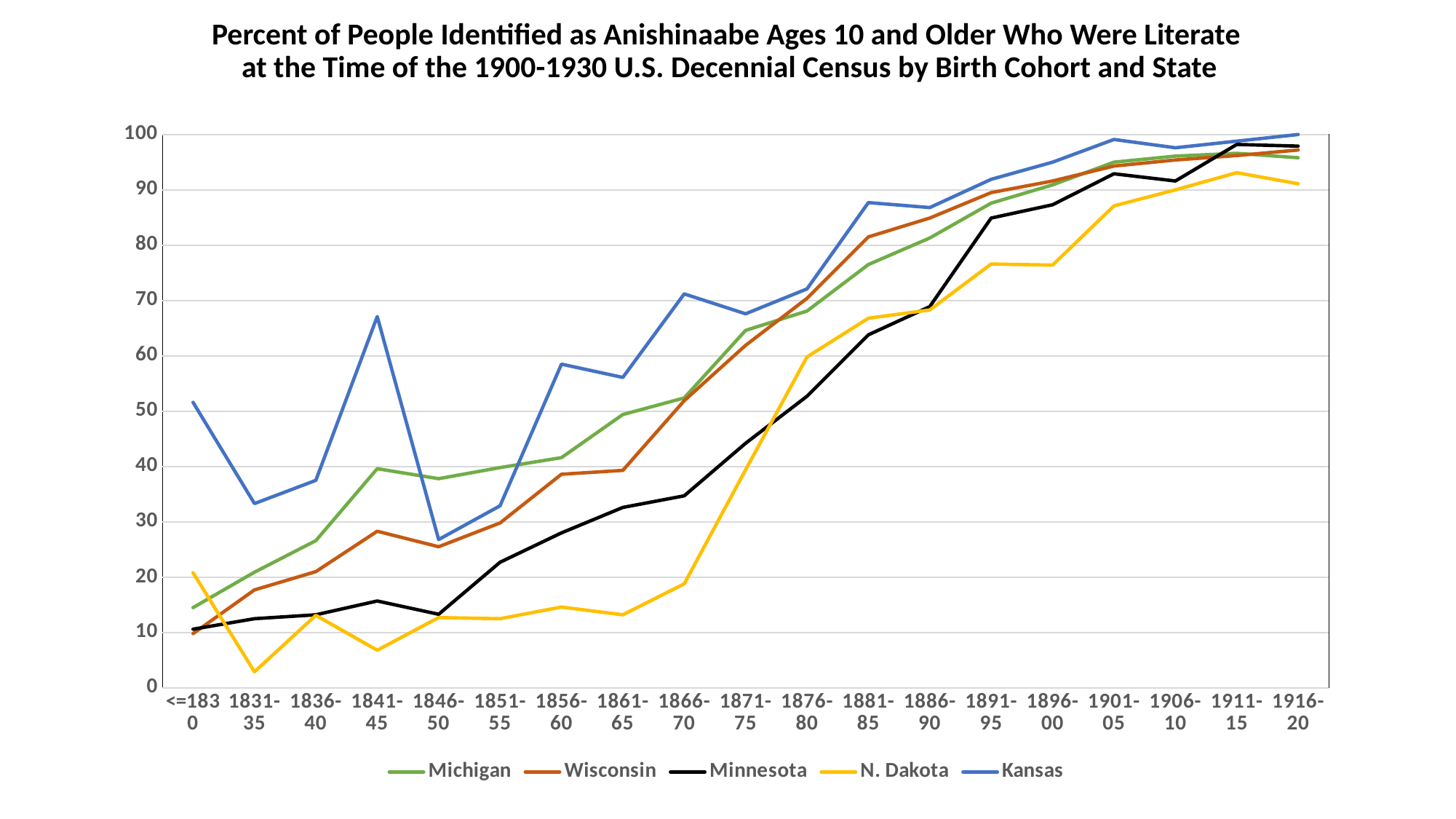
Which state has the highest literacy percentage for the 1841-45 birth cohort? Kansas How many birth cohorts are shown along the x axis? 19 Does the Minnesota line generally rise or fall from the earliest to the latest birth cohort? rise Which colour is used for the Minnesota line? black How many series does the legend list? 5 Which state has the lowest literacy percentage for the 1916-20 birth cohort? N. Dakota Which state has the lowest literacy percentage for the 1831-35 birth cohort? N. Dakota Is the value for Kansas in the 1841-45 cohort greater or less than 60? greater Is the value for N. Dakota in the 1831-35 cohort greater or less than 10? less What kind of chart is shown on the slide? line chart Is the value for Minnesota in the 1891-95 cohort greater or less than 80? greater For the 1911-15 cohort, which is higher, Minnesota or N. Dakota? Minnesota